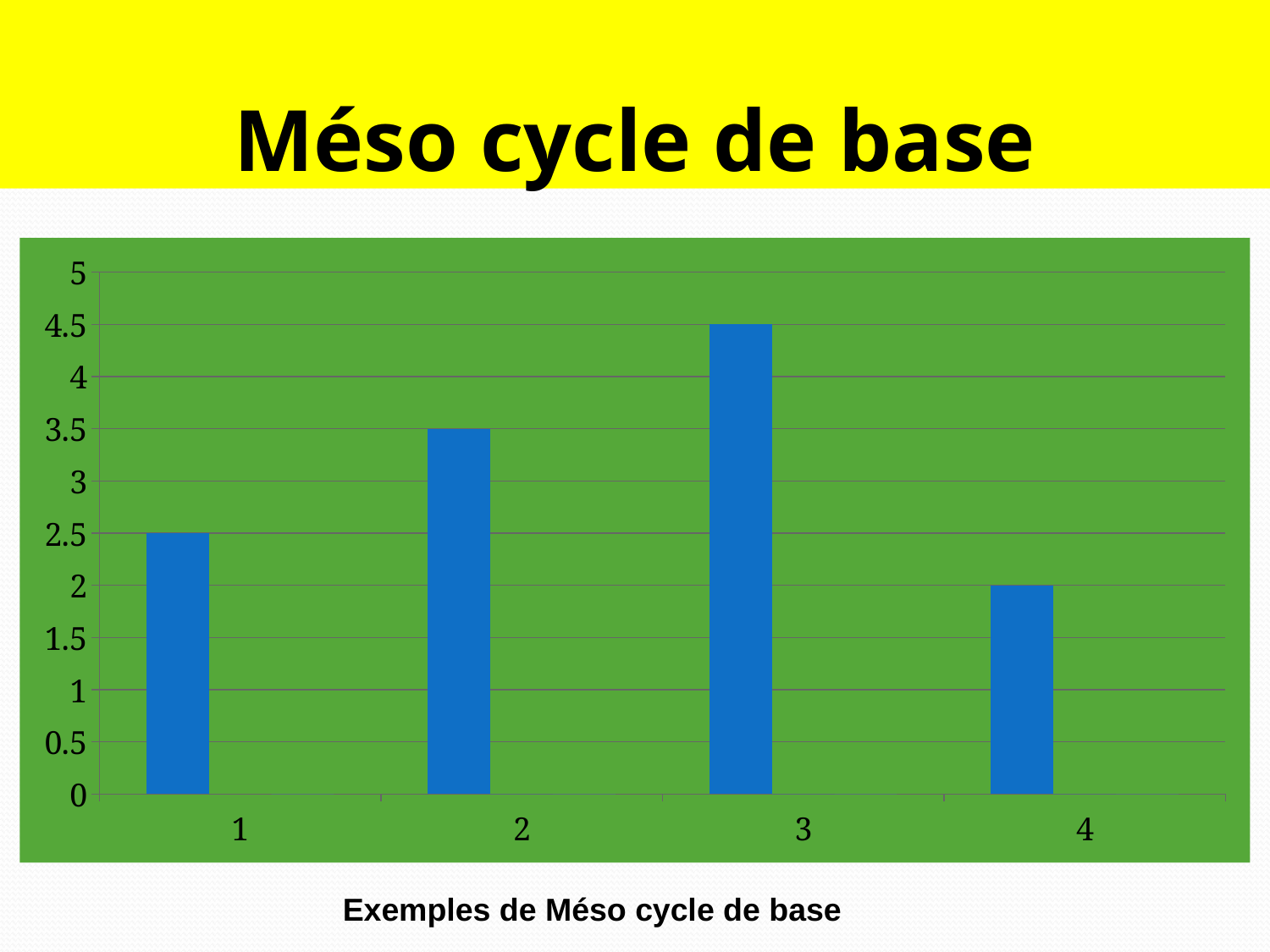
What is the value of the bar for category 3? 4.5 What is the value of the bar for category 2? 3.5 Which category has the lowest bar? 4 Which category has the highest bar? 3 What is the caption printed below the chart? Exemples de Méso cycle de base What is the difference between the values for category 3 and category 1? 2 How many bars are plotted in the chart? 4 What is the value of the bar for category 1? 2.5 What is the value of the bar for category 4? 2 Which is larger, the value for category 2 or the value for category 4? category 2 Is the value for category 1 greater or less than 3? less What kind of chart is shown on the slide? bar chart